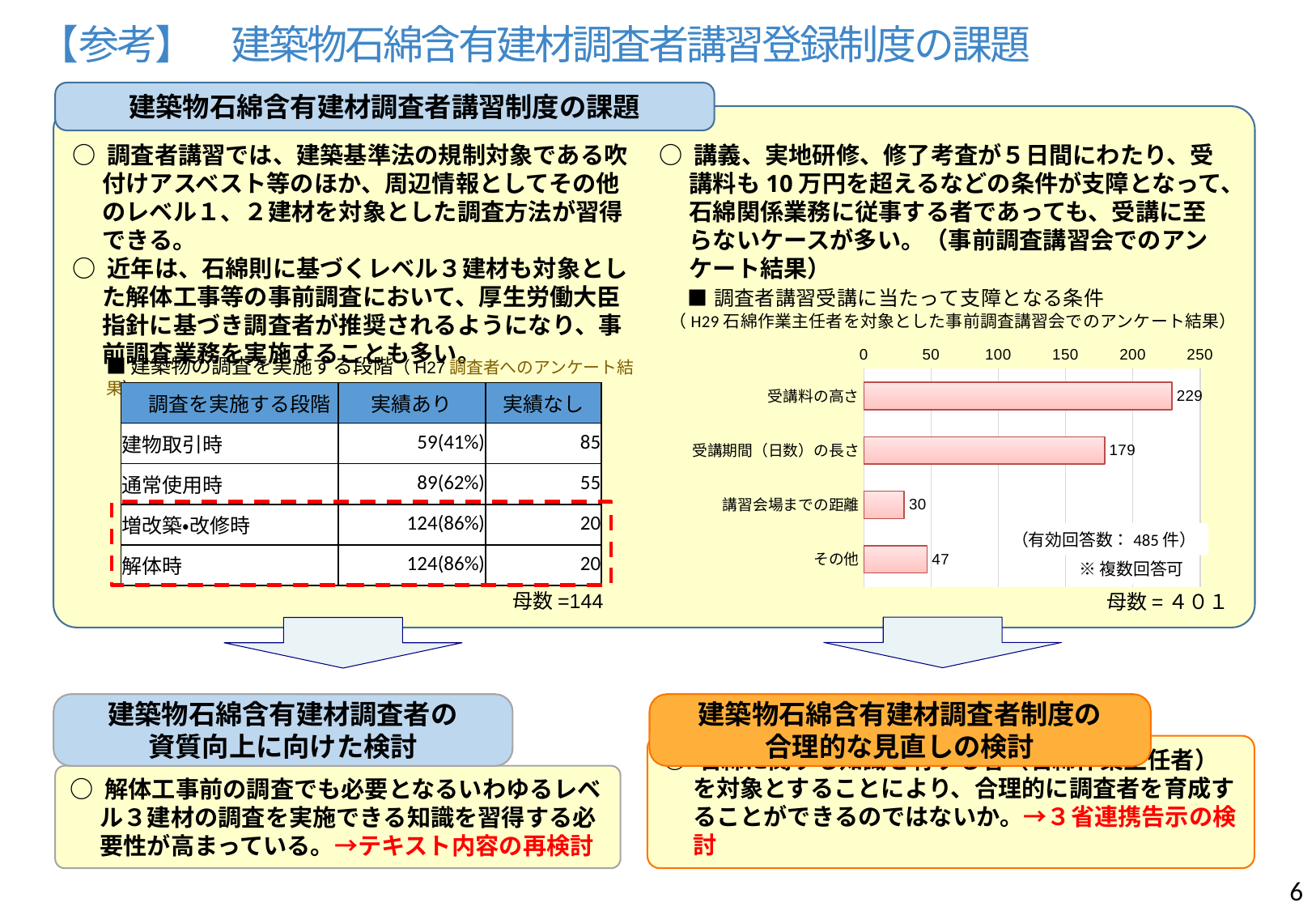
Which category has the lowest value in the chart? 講習会場までの距離 Which category has the highest value in the chart? 受講料の高さ What is the maximum value shown on the chart's horizontal axis? 250 Is the value for 受講期間（日数）の長さ greater or less than 150? greater What is the value for その他 in the chart? 47 Which is larger, the value for その他 or the value for 講習会場までの距離? その他 How many categories are shown in the chart? 4 What is the value for 講習会場までの距離 in the chart? 30 What is the value for 受講料の高さ in the chart? 229 What is the difference between the values for 受講料の高さ and 受講期間（日数）の長さ? 50 What type of chart is shown on the slide? bar chart What is the value for 受講期間（日数）の長さ in the chart? 179